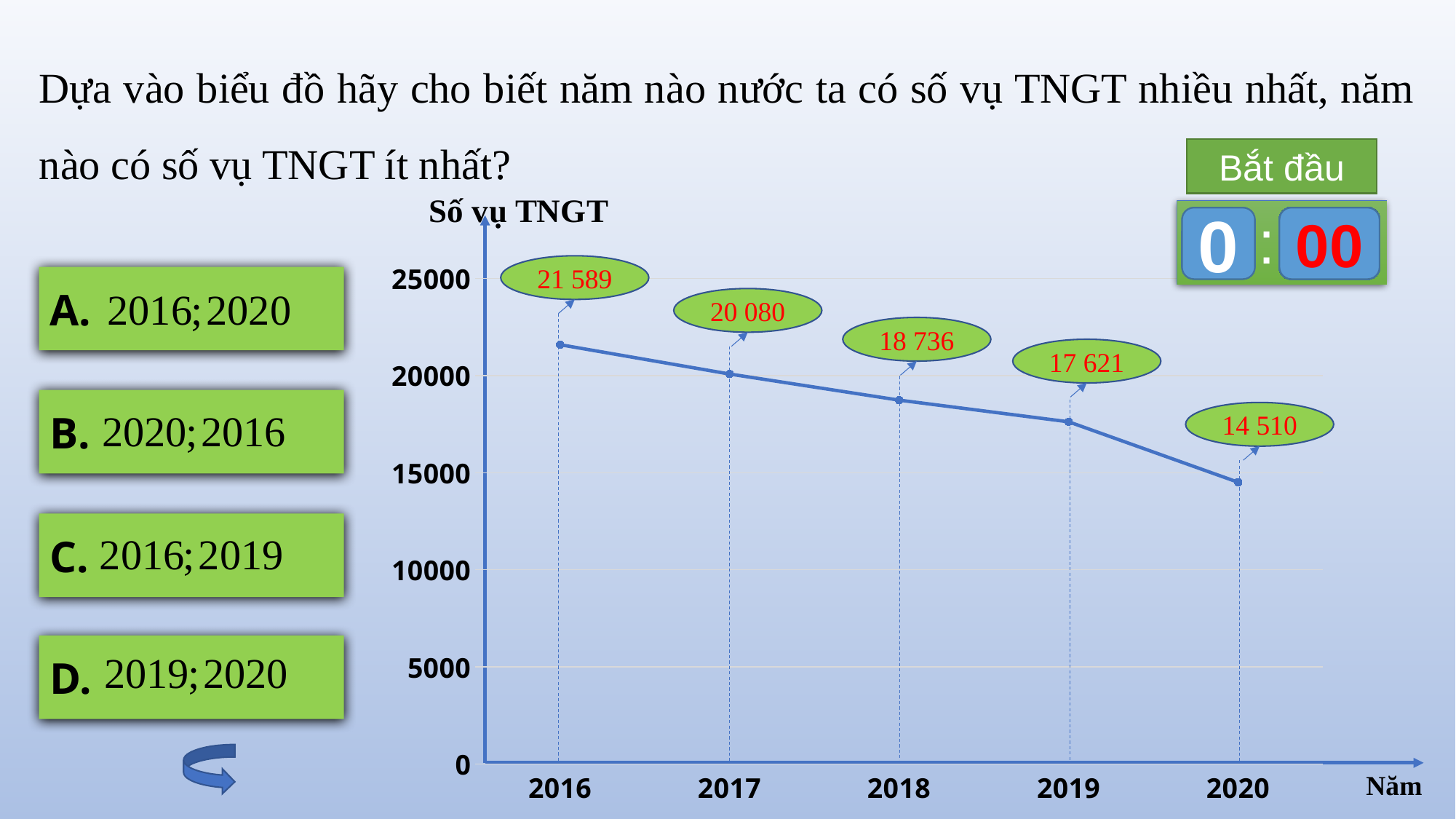
What is the number of TNGT cases (Số vụ TNGT) in 2016? 21 589 Which year has more TNGT cases, 2017 or 2019? 2017 What is the difference between the number of TNGT cases in 2016 and in 2020? 7 079 What is the number of TNGT cases in 2020? 14 510 How many years are plotted on the chart? 5 Which year has the lowest number of TNGT cases? 2020 What is the difference between the number of TNGT cases in 2017 and in 2018? 1 344 Is the value for 2019 greater or less than 15000? greater Which year has the highest number of TNGT cases? 2016 What kind of chart is shown on the slide? line chart Do the values rise or fall from 2016 to 2020? fall What is the number of TNGT cases in 2018? 18 736